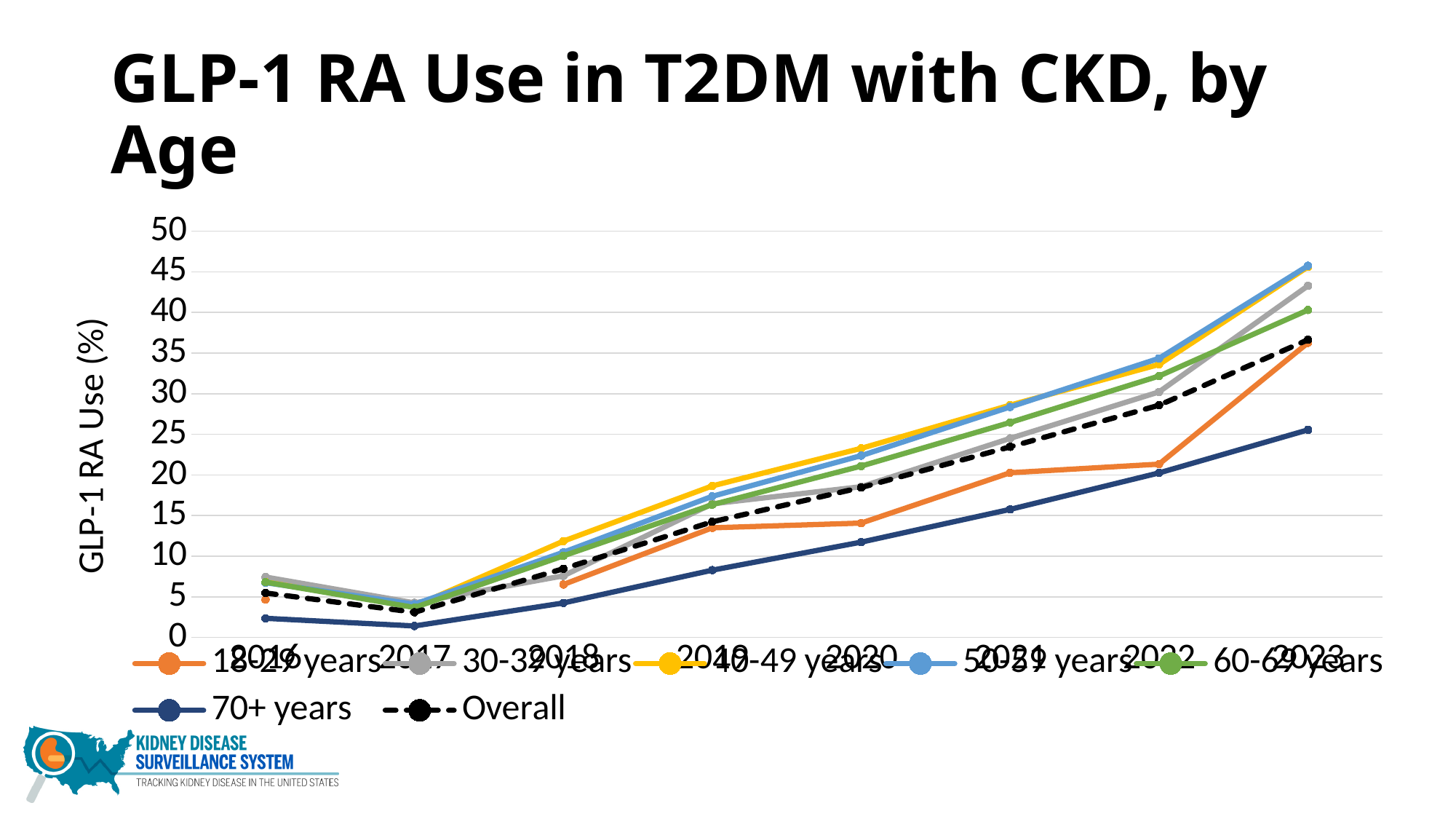
Is the value for 70+ years in 2023 greater or less than 30? less Which age group has the lowest GLP-1 RA use in 2023? 70+ years Is the value for 18-29 years in 2022 greater or less than 25? less Which series has the lowest value in 2017? 70+ years What is the label of the y axis? GLP-1 RA Use (%) How many series does the legend list? 7 What kind of chart is shown on the slide? line chart How many years are plotted along the x axis? 8 Is the value for 50-59 years in 2023 greater or less than 40? greater What is the title of the chart? GLP-1 RA Use in T2DM with CKD, by Age Does the Overall series rise or fall from 2017 to 2023? rise Which is higher in 2023, 18-29 years or 70+ years? 18-29 years